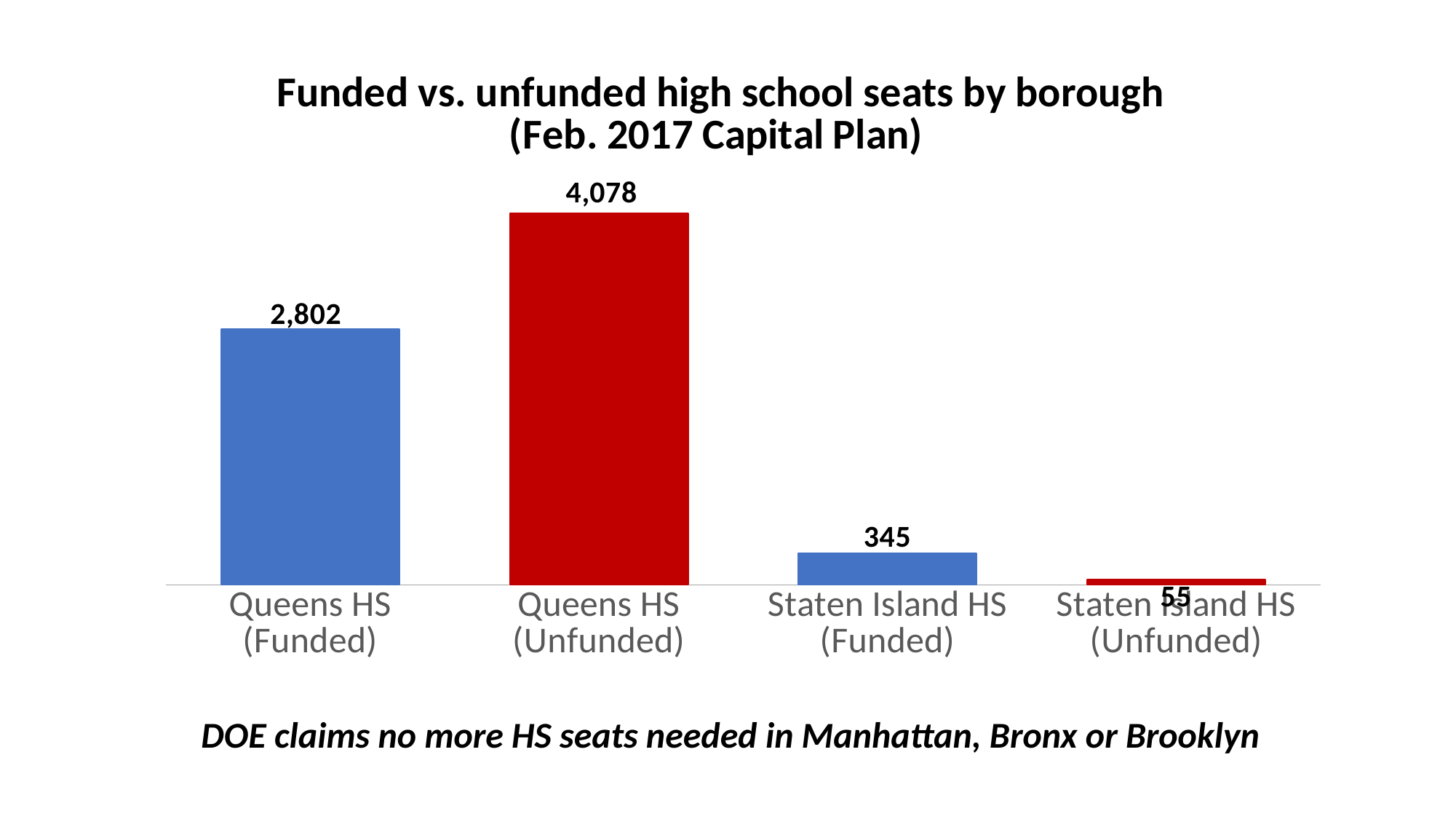
How many categories are shown in the chart? 4 What is the title of the chart? Funded vs. unfunded high school seats by borough (Feb. 2017 Capital Plan) What is the difference between Staten Island HS (Funded) and Staten Island HS (Unfunded)? 290 What kind of chart is shown on the slide? Bar chart What is the value for Queens HS (Unfunded)? 4,078 What is the value for Staten Island HS (Unfunded)? 55 What is the value for Staten Island HS (Funded)? 345 Which is larger, Queens HS (Funded) or Staten Island HS (Funded)? Queens HS (Funded) Which category has the lowest value? Staten Island HS (Unfunded) Which category has the highest value? Queens HS (Unfunded) What is the difference between Queens HS (Unfunded) and Queens HS (Funded)? 1,276 What is the value for Queens HS (Funded)? 2,802